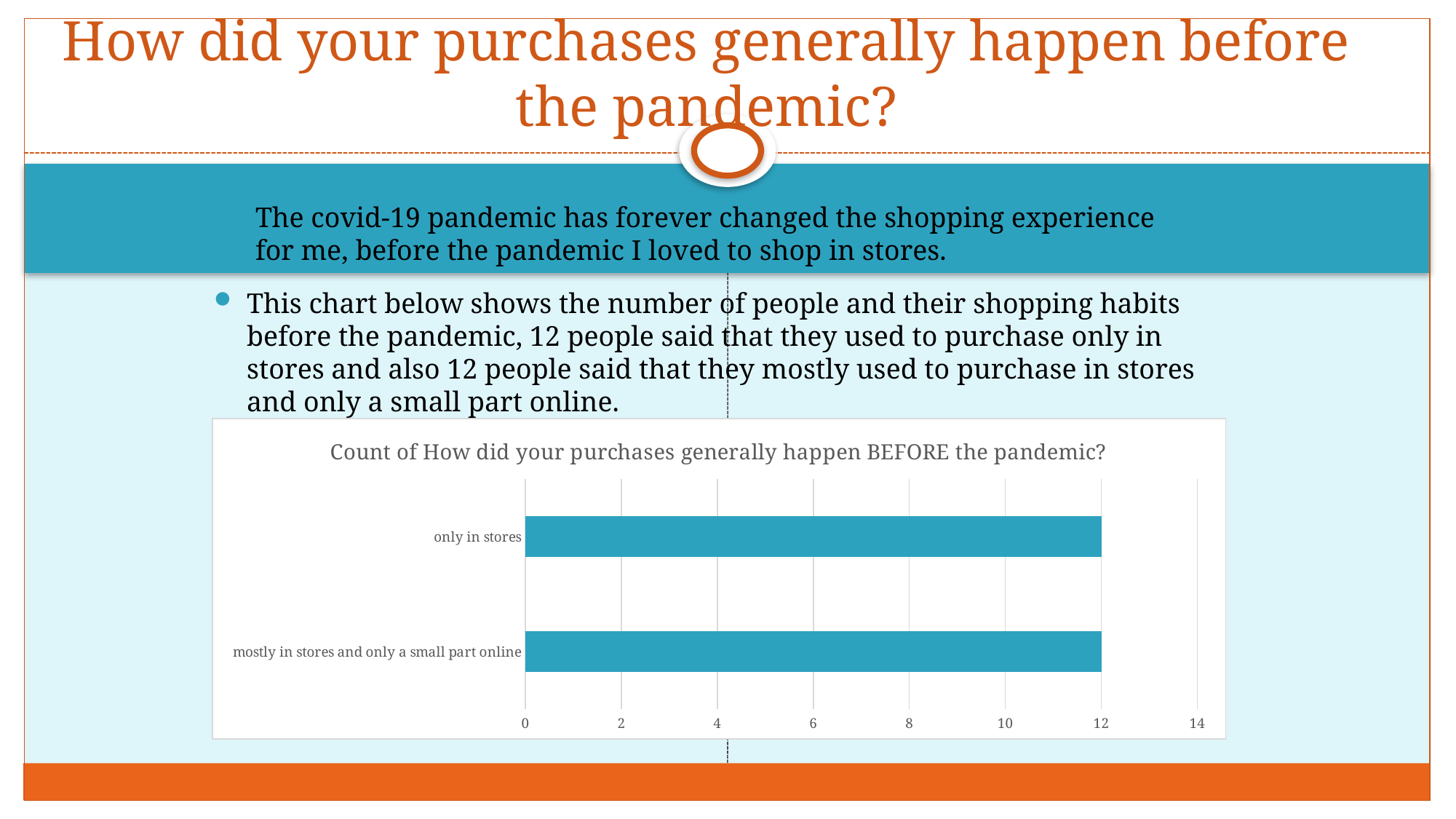
Is the value for "mostly in stores and only a small part online" greater or less than 14? less What is the value for "mostly in stores and only a small part online"? 12 What kind of chart is shown on the slide? Bar chart What is the value for "only in stores"? 12 What is the highest value shown on the horizontal axis of the chart? 14 Is the value for "only in stores" greater or less than 10? greater What is the title of the chart? Count of How did your purchases generally happen BEFORE the pandemic? What is the difference between the values for "only in stores" and "mostly in stores and only a small part online"? 0 How many categories are shown in the chart? 2